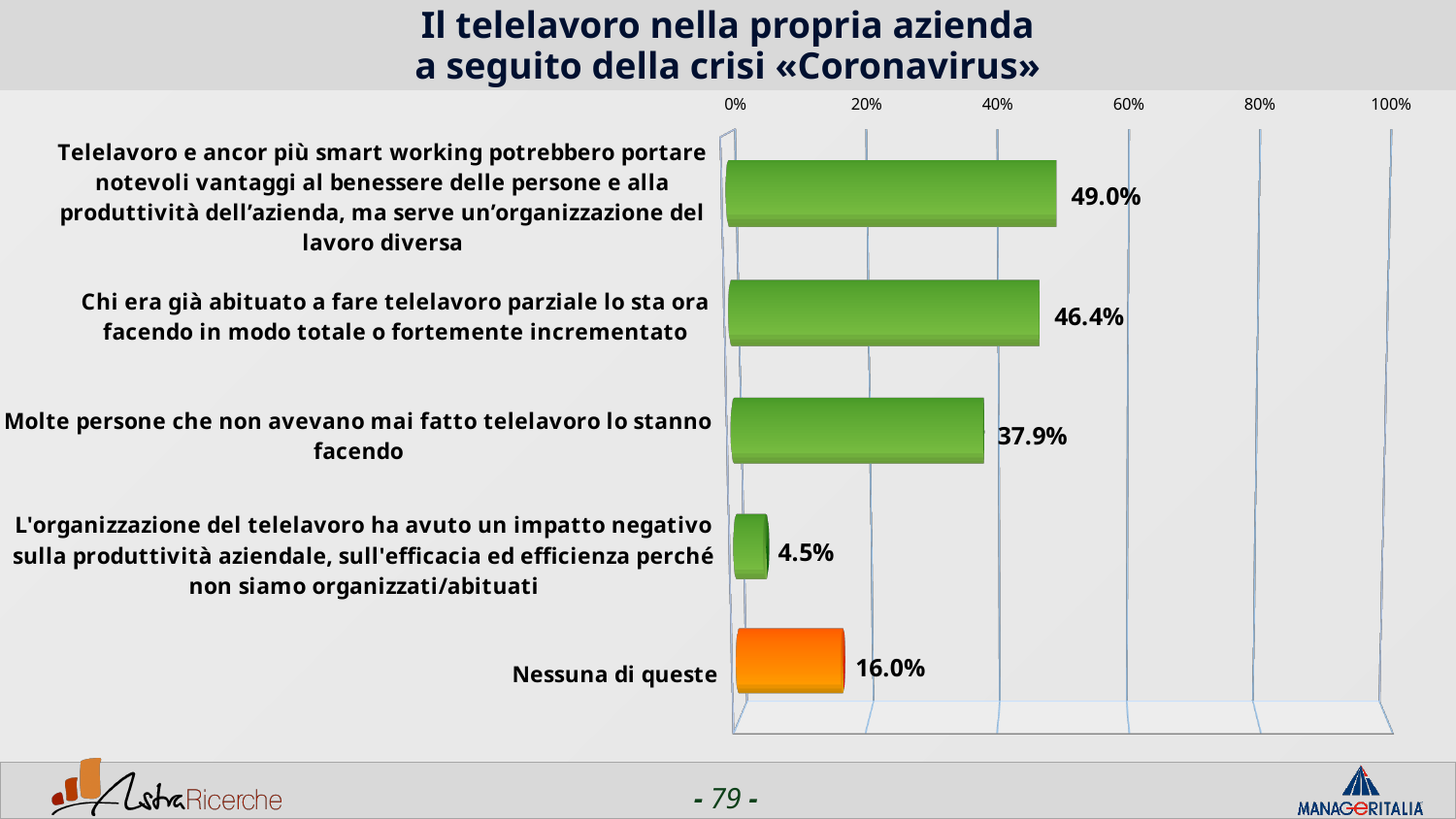
Which is larger: the value for "Molte persone che non avevano mai fatto telelavoro lo stanno facendo" or the value for "Nessuna di queste"? Molte persone che non avevano mai fatto telelavoro lo stanno facendo Which bar is coloured orange rather than green? Nessuna di queste What is the difference between the value for "Nessuna di queste" and the value for "L'organizzazione del telelavoro ha avuto un impatto negativo..."? 11.5% Which category has the highest value? Telelavoro e ancor più smart working potrebbero portare notevoli vantaggi al benessere delle persone e alla produttività dell'azienda, ma serve un'organizzazione del lavoro diversa Which category has the lowest value? L'organizzazione del telelavoro ha avuto un impatto negativo sulla produttività aziendale, sull'efficacia ed efficienza perché non siamo organizzati/abituati What is the difference between the value for "Telelavoro e ancor più smart working potrebbero portare notevoli vantaggi..." and the value for "Chi era già abituato a fare telelavoro parziale..."? 2.6% What kind of chart is shown on the slide? bar chart How many categories are shown in the chart? 5 What is the value for "Nessuna di queste"? 16.0% What is the value for "Chi era già abituato a fare telelavoro parziale lo sta ora facendo in modo totale o fortemente incrementato"? 46.4% Is the value for "Molte persone che non avevano mai fatto telelavoro lo stanno facendo" greater or less than 40%? less What is the value for "Molte persone che non avevano mai fatto telelavoro lo stanno facendo"? 37.9%